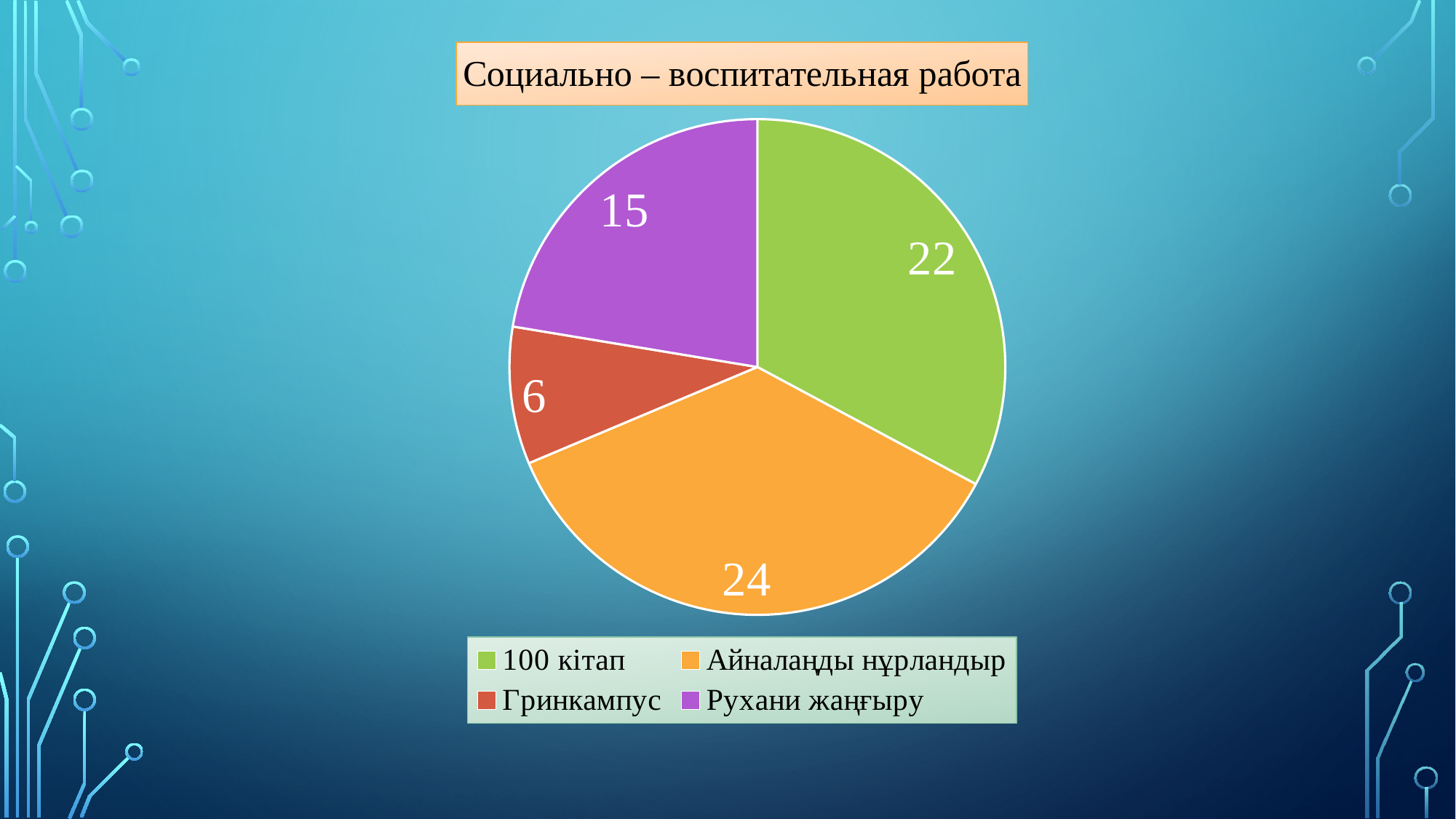
What kind of chart is shown on the slide? Pie chart Which category has the smallest slice? Гринкампус What is the value for Рухани жаңғыру? 15 What is the title of the chart? Социально – воспитательная работа What is the value for Гринкампус? 6 What is the difference between the values for Рухани жаңғыру and Гринкампус? 9 What is the value for Айналаңды нұрландыр? 24 Which is larger, the value for Рухани жаңғыру or the value for Гринкампус? Рухани жаңғыру Which category has the largest slice? Айналаңды нұрландыр How many categories does the pie chart show? 4 What is the difference between the values for Айналаңды нұрландыр and 100 кітап? 2 What is the value for 100 кітап? 22